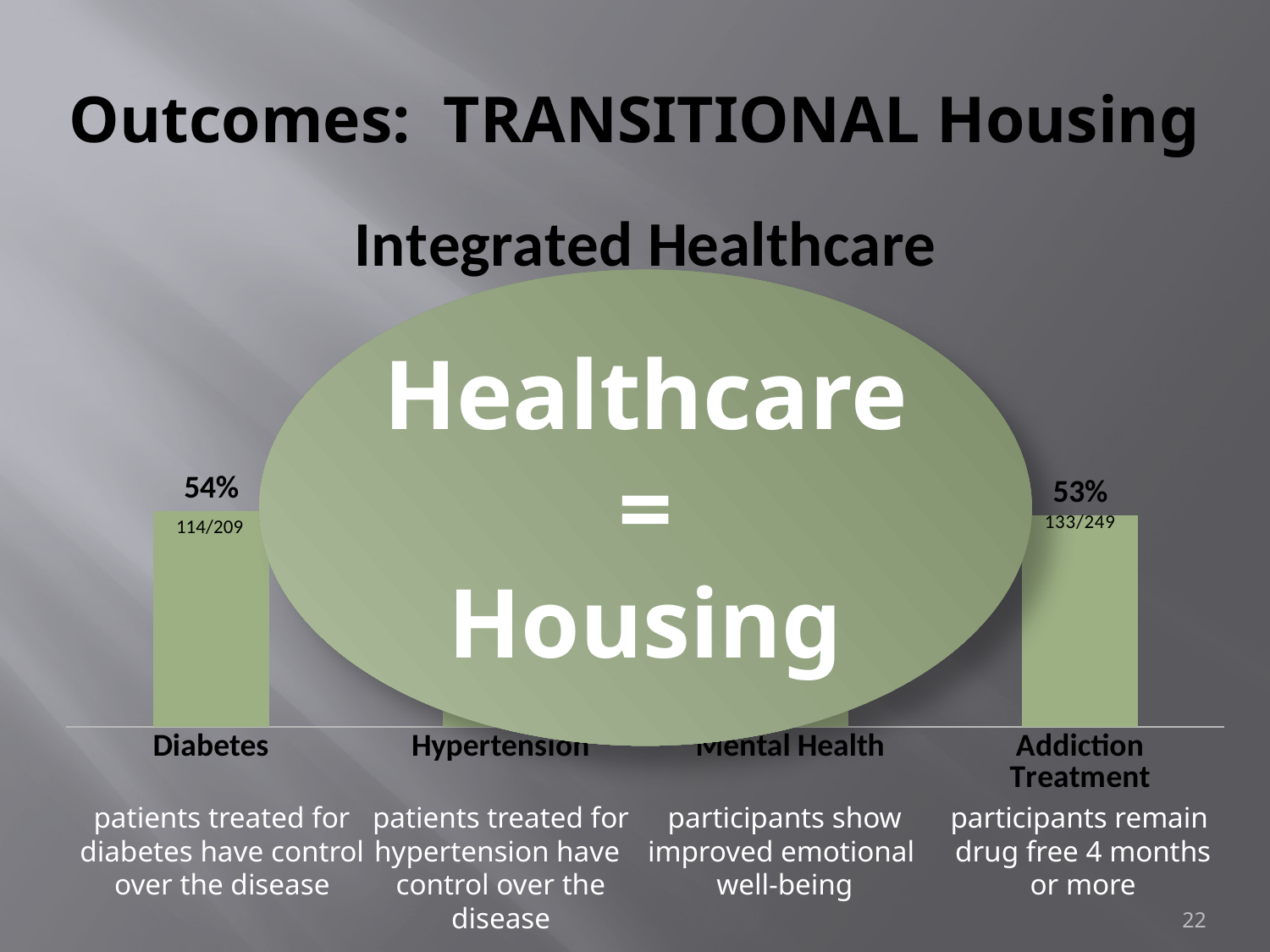
Which category is labelled furthest to the right on the x axis? Addiction Treatment What colour are the bars in the chart? Green What fraction is printed under the 54% label for Diabetes? 114/209 What is the value shown for Diabetes in the chart? 54% What is the difference in percentage points between Diabetes (54%) and Addiction Treatment (53%)? 1 percentage point What is the title of the chart? Integrated Healthcare What fraction is printed under the 53% label for Addiction Treatment? 133/249 Which has the larger percentage, Diabetes or Addiction Treatment? Diabetes How many categories are shown along the x axis of the chart? 4 What is the value shown for Addiction Treatment in the chart? 53% What kind of chart is shown on the slide? Bar chart